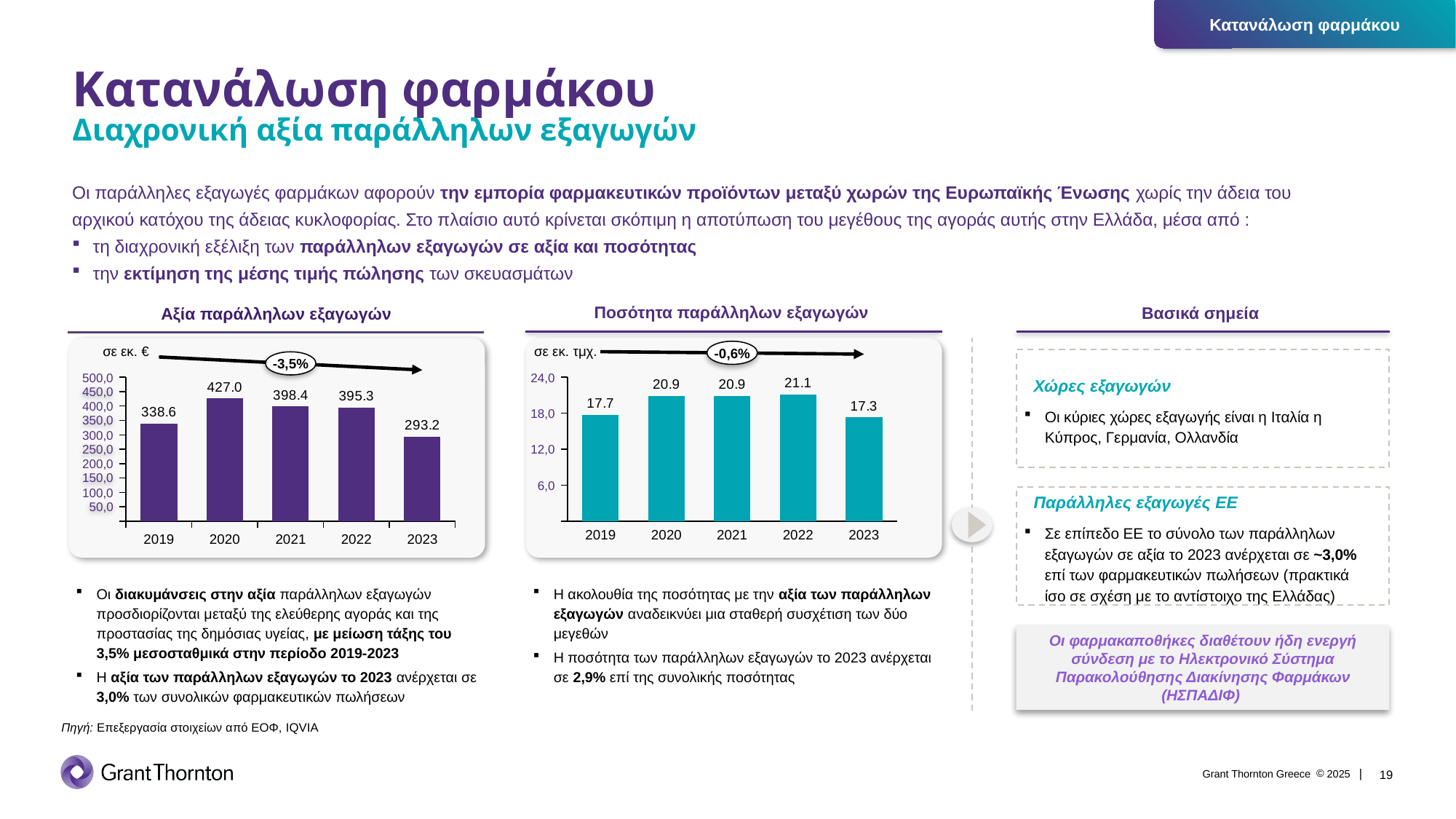
In the 'Ποσότητα παράλληλων εξαγωγών' chart, which year has the lowest value? 2023 In the 'Αξία παράλληλων εξαγωγών' chart, what is the difference between the 2020 and 2019 values? 88.4 What kind of chart is the 'Ποσότητα παράλληλων εξαγωγών' chart? bar chart In the 'Αξία παράλληλων εξαγωγών' chart, which year has the lowest value? 2023 In the 'Αξία παράλληλων εξαγωγών' chart, what is the value for 2023? 293.2 In the 'Ποσότητα παράλληλων εξαγωγών' chart, what is the value for 2022? 21.1 What percentage change is shown in the label above the 'Αξία παράλληλων εξαγωγών' chart? -3,5% In the 'Ποσότητα παράλληλων εξαγωγών' chart, what is the value for 2019? 17.7 In the 'Ποσότητα παράλληλων εξαγωγών' chart, is the value for 2021 larger or smaller than the value for 2023? larger In the 'Αξία παράλληλων εξαγωγών' chart, what is the value for 2020? 427.0 In the 'Αξία παράλληλων εξαγωγών' chart, how many years are shown on the x axis? 5 In the 'Αξία παράλληλων εξαγωγών' chart, which year has the highest value? 2020